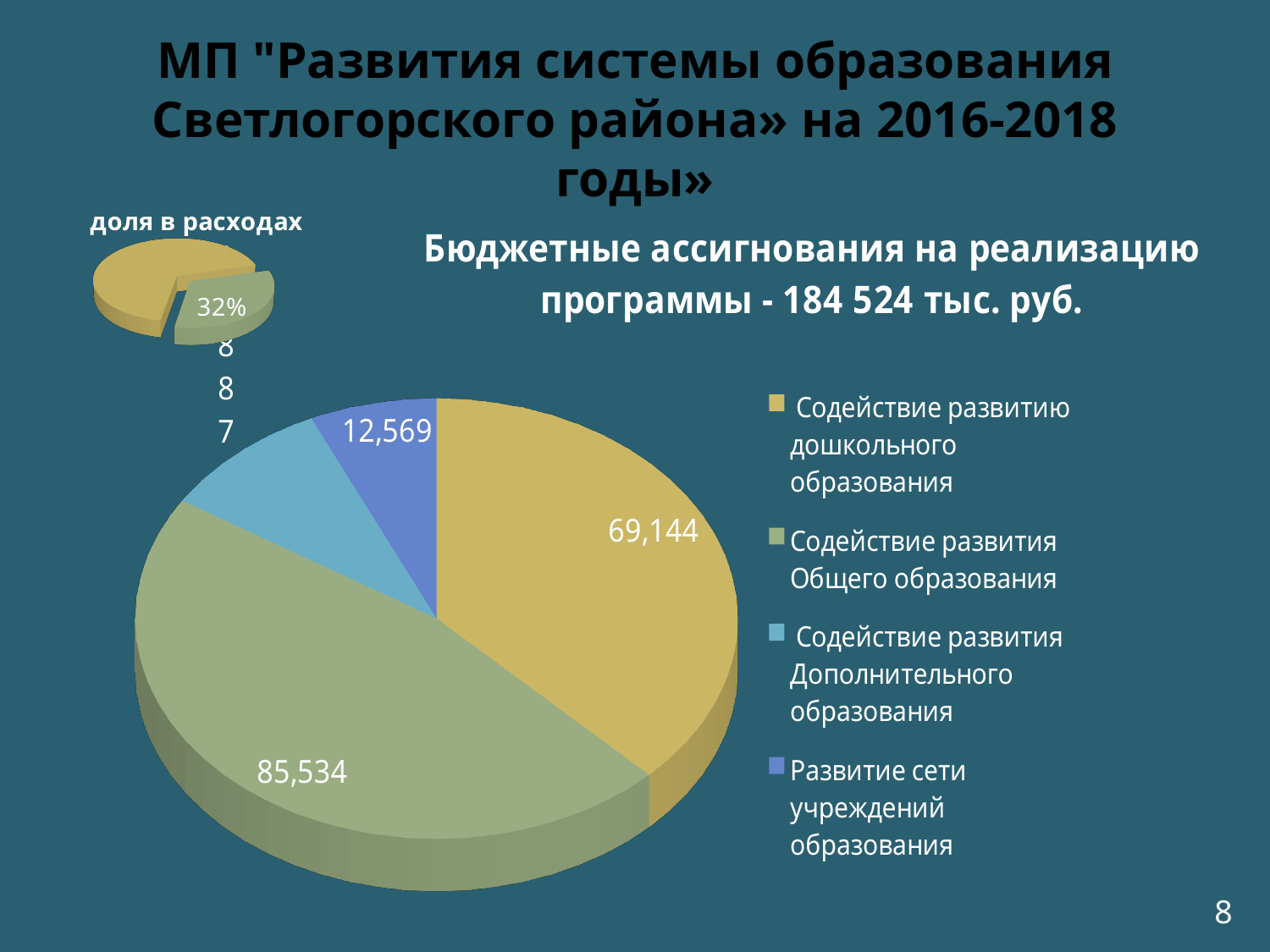
What kind of chart is the large chart on the slide? Pie chart How many slices does the large pie chart have? 4 In the large pie chart, which is larger: Содействие развитию дошкольного образования or Содействие развития Общего образования? Содействие развития Общего образования In the large pie chart, what is the difference between the values for Содействие развития Общего образования and Содействие развитию дошкольного образования? 16,390 How many entries does the legend of the large pie chart list? 4 In the large pie chart, which category has the smallest slice? Развитие сети учреждений образования In the large pie chart, what is the value for Содействие развитию дошкольного образования? 69,144 In the large pie chart, which category has the largest slice? Содействие развития Общего образования In the large pie chart, what is the value for Развитие сети учреждений образования? 12,569 In the large pie chart, what is the value for Содействие развития Общего образования? 85,534 In the large pie chart, what is the difference between the values for Содействие развитию дошкольного образования and Развитие сети учреждений образования? 56,575 In the small pie chart titled "доля в расходах", what percentage label is shown on the separated slice? 32%